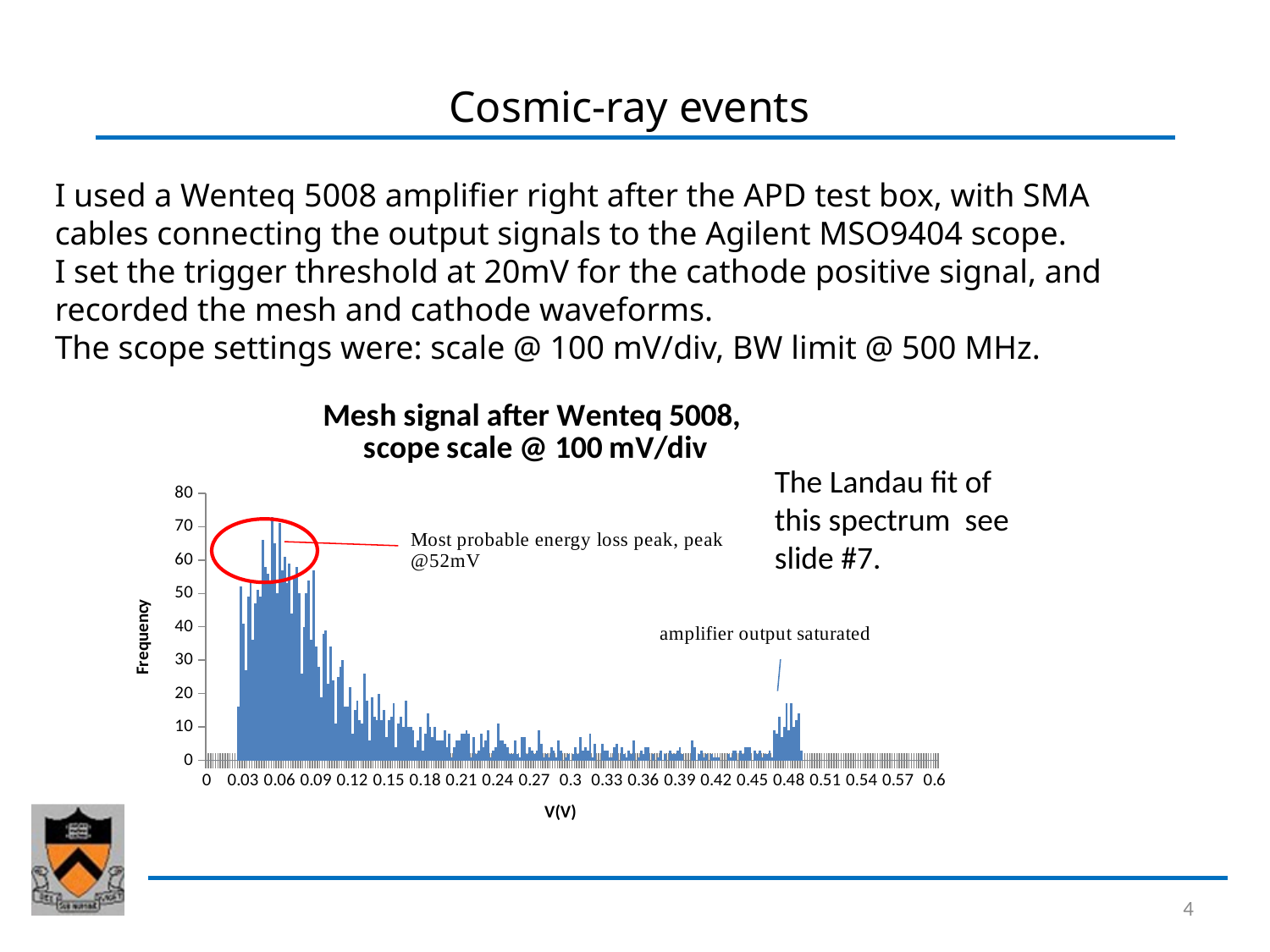
What is the title of the chart? Mesh signal after Wenteq 5008, scope scale @ 100 mV/div Are the bars near 0.3 V on the x axis greater or less than 10? less What kind of chart is shown on the slide? bar chart What is the highest value shown on the vertical axis of the chart? 80 Do the bar heights generally rise or fall as the voltage increases from 0.06 V to 0.45 V? fall Is the tallest bar in the chart greater or less than 60? greater According to the annotation on the chart, at what voltage is the most probable energy loss peak? 52mV Which region of the x axis has taller bars: around 0.06 V or around 0.3 V? around 0.06 V What is the label of the vertical axis of the chart? Frequency Are the bars near 0.48 V on the x axis greater or less than 20? less